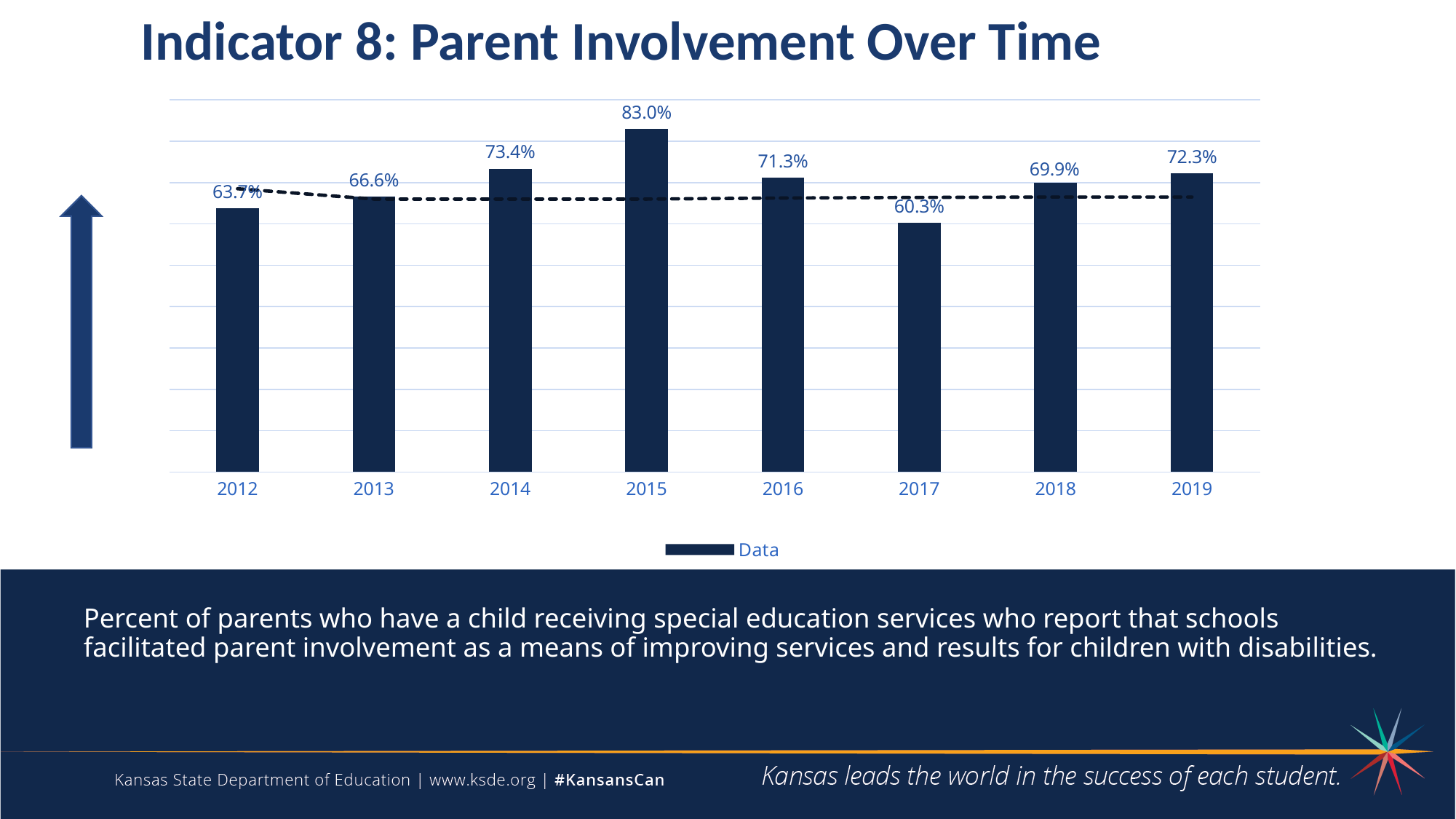
What is the value for 2015? 83.0% Which year has the lowest value? 2017 Which is larger, the value for 2014 or the value for 2016? 2014 What is the value for 2012? 63.7% How many years are shown on the x axis? 8 What is the value for 2019? 72.3% What kind of chart is shown on the slide? combination bar and line chart What is the difference between the values for 2015 and 2017? 22.7% Do the values rise or fall from 2017 to 2019? rise How many series does the legend list? 1 What is the title of the chart? Indicator 8: Parent Involvement Over Time Which year has the highest value? 2015